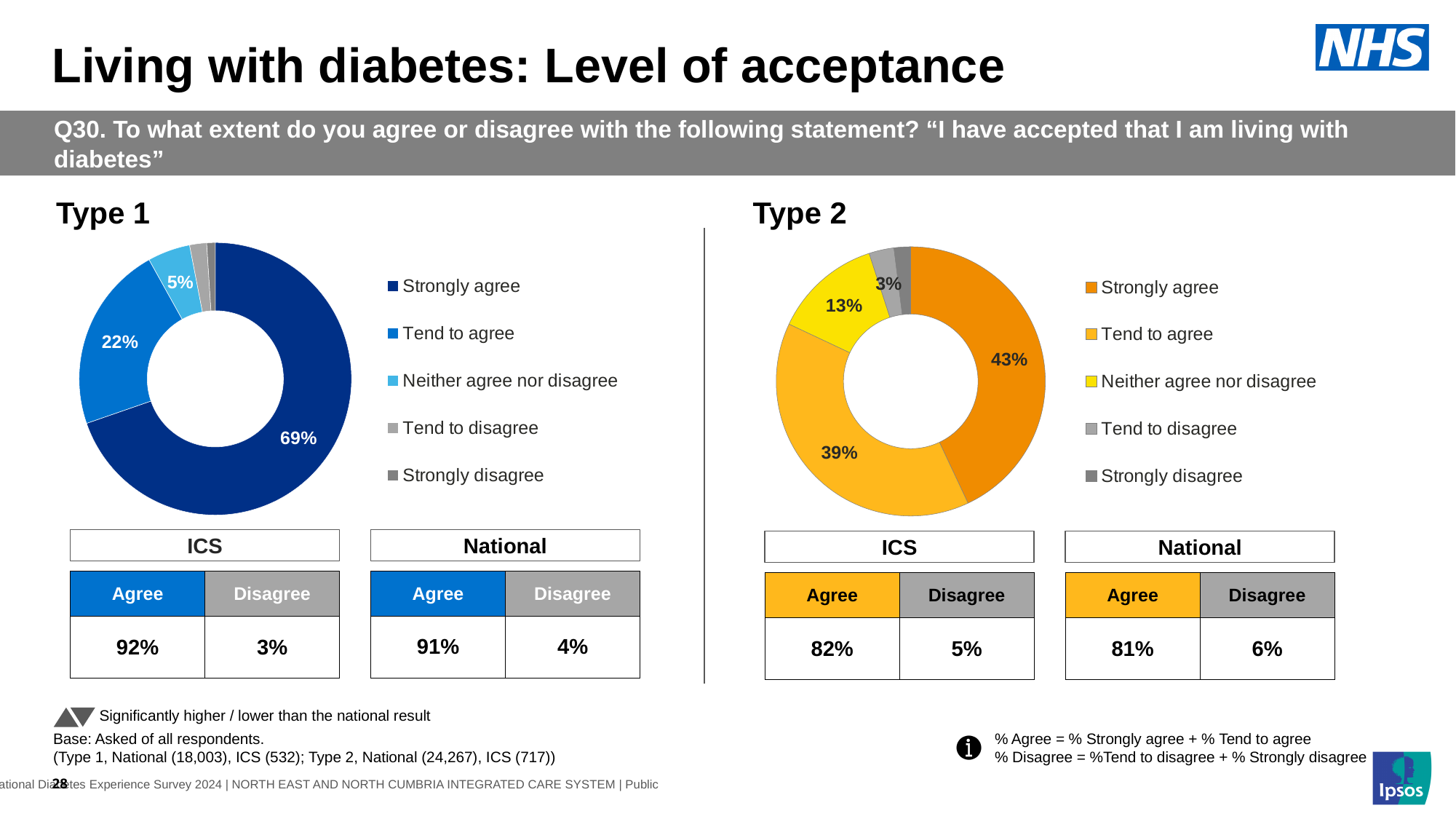
In the Type 2 chart, which category has the largest slice? Strongly agree In the Type 1 chart, which category has the largest slice? Strongly agree In the Type 1 chart, what percentage of respondents strongly agree? 69% In the Type 2 chart, what percentage of respondents strongly agree? 43% How many categories does the legend of the Type 2 chart list? 5 In the Type 2 chart, what percentage of respondents tend to agree? 39% What kind of chart is used for Type 1? Donut (pie) chart In the Type 2 chart, what share of the pie is 'Neither agree nor disagree'? 13% In the Type 1 chart, what is the difference between the 'Strongly agree' and 'Tend to agree' percentages? 47% Which chart has the larger 'Strongly agree' share, Type 1 or Type 2? Type 1 In the Type 1 chart, what percentage of respondents tend to agree? 22% In the Type 1 chart, what share of the pie is 'Neither agree nor disagree'? 5%